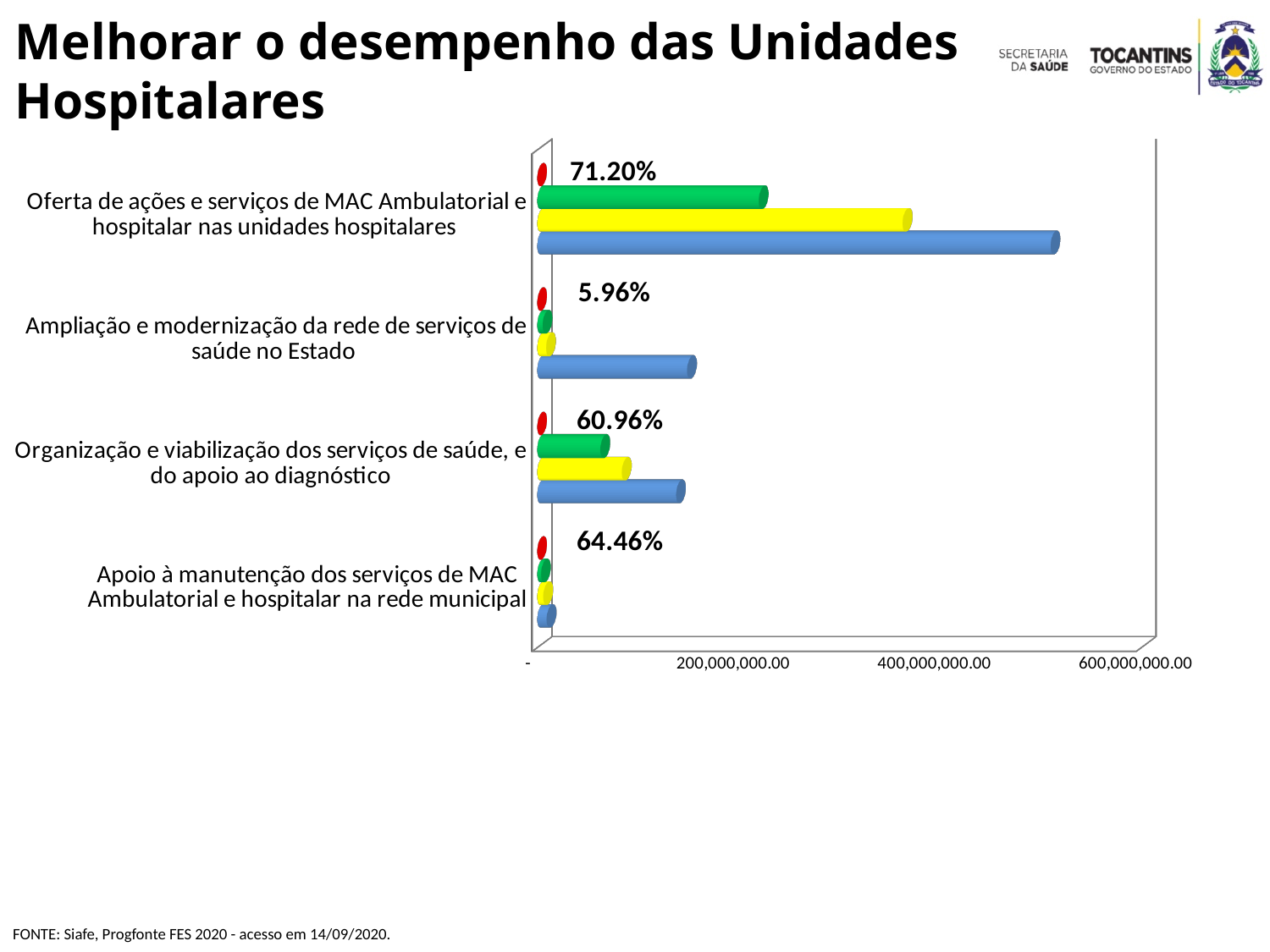
Which category has the lowest percentage label? Ampliação e modernização da rede de serviços de saúde no Estado What is the difference in percentage points between the labels for "Oferta de ações e serviços de MAC Ambulatorial e hospitalar nas unidades hospitalares" and "Ampliação e modernização da rede de serviços de saúde no Estado"? 65.24 percentage points Which category has the highest percentage label? Oferta de ações e serviços de MAC Ambulatorial e hospitalar nas unidades hospitalares Which has a longer blue bar: "Oferta de ações e serviços de MAC Ambulatorial e hospitalar nas unidades hospitalares" or "Organização e viabilização dos serviços de saúde, e do apoio ao diagnóstico"? Oferta de ações e serviços de MAC Ambulatorial e hospitalar nas unidades hospitalares What type of chart is shown on the slide? Bar chart What percentage is shown for "Ampliação e modernização da rede de serviços de saúde no Estado"? 5.96% What percentage is shown for "Oferta de ações e serviços de MAC Ambulatorial e hospitalar nas unidades hospitalares"? 71.20% Is the blue bar for "Ampliação e modernização da rede de serviços de saúde no Estado" greater or less than 200,000,000.00? less What percentage is shown for "Organização e viabilização dos serviços de saúde, e do apoio ao diagnóstico"? 60.96% Is the blue bar for "Oferta de ações e serviços de MAC Ambulatorial e hospitalar nas unidades hospitalares" greater or less than 400,000,000.00? greater What percentage is shown for "Apoio à manutenção dos serviços de MAC Ambulatorial e hospitalar na rede municipal"? 64.46% How many categories are shown on the chart? 4